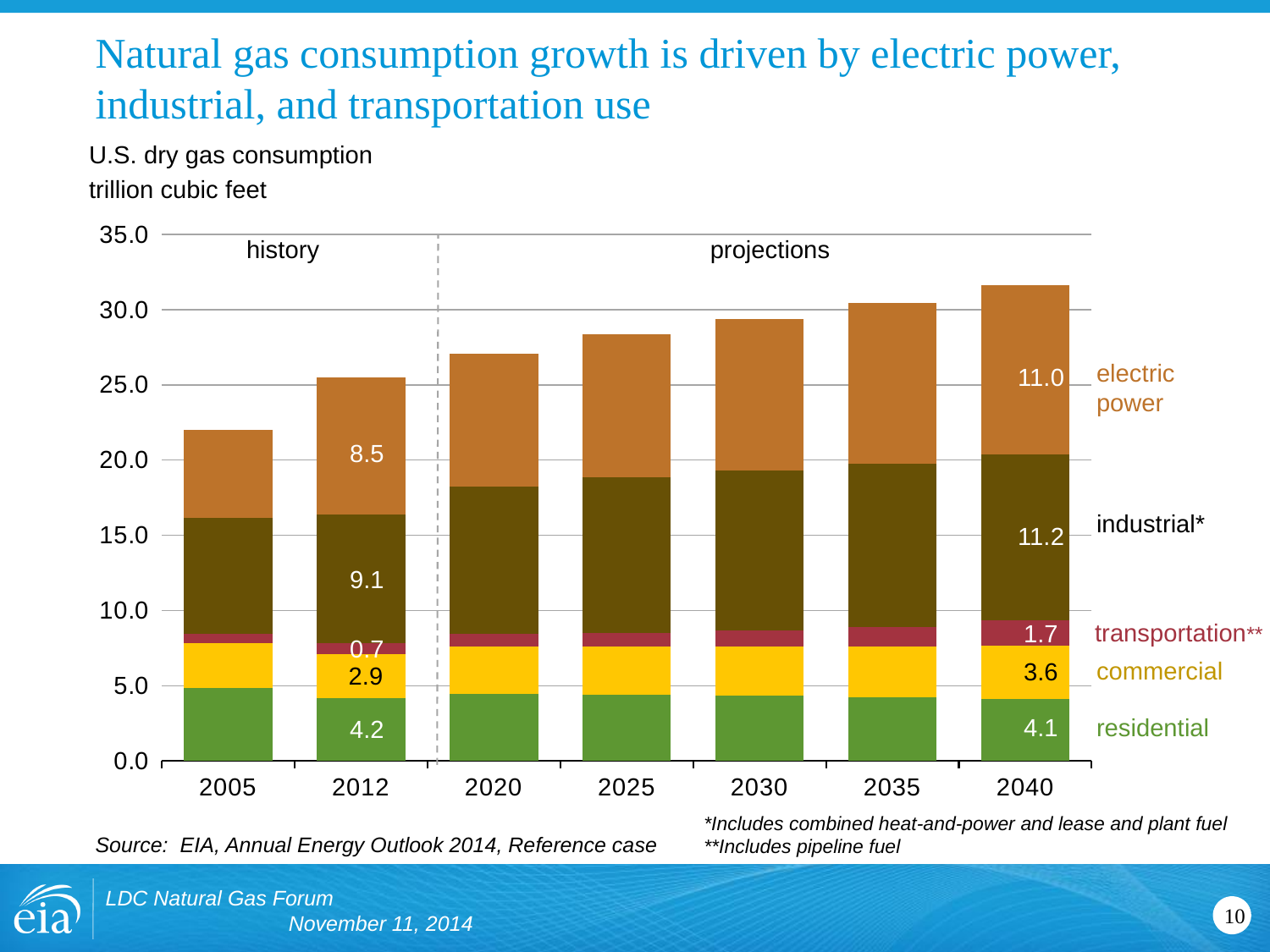
What is the commercial value for 2012? 2.9 How many series (sectors) are stacked in each bar? 5 Which is larger, the residential value in 2012 or in 2040? 2012 What is the total of the stacked bar for 2012? 25.5 What is the transportation** value for 2040? 1.7 How many years are shown on the x axis? 7 Is the total value for 2005 greater or less than 20.0? greater By how much does the electric power value in 2040 exceed the electric power value in 2012? 2.5 What is the total of the stacked bar for 2040? 31.6 What is the industrial* value for 2040? 11.2 What is the electric power value for 2012? 8.5 Which year has the highest total consumption? 2040